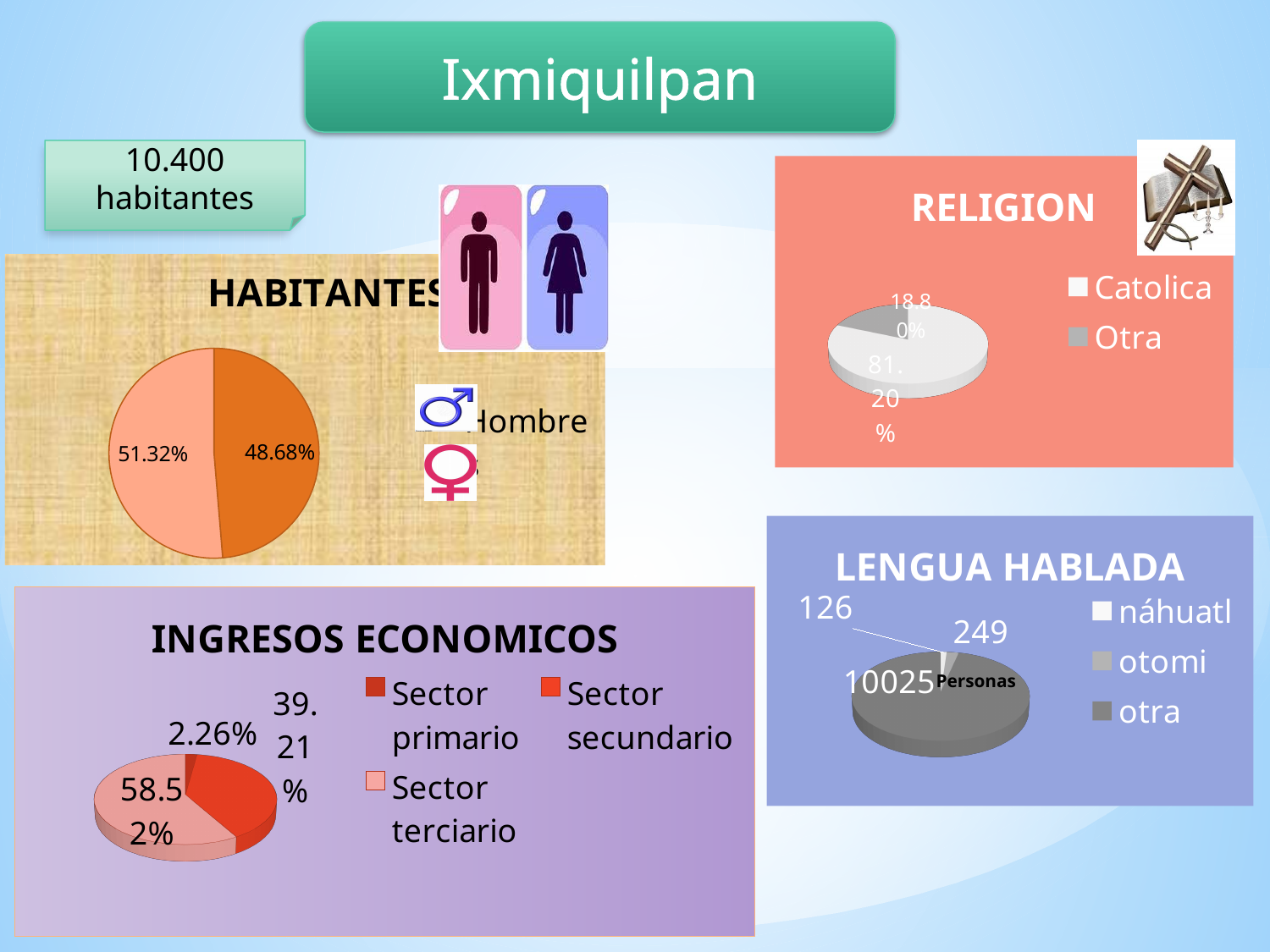
In the LENGUA HABLADA chart, what is the difference between the values for otomi and náhuatl? 123 In the LENGUA HABLADA chart, how many people are shown for náhuatl? 126 In the RELIGION chart, what percentage is shown for Catolica? 81.20% In the RELIGION chart, which category has the larger share, Catolica or Otra? Catolica In the INGRESOS ECONOMICOS chart, what percentage is shown for Sector primario? 2.26% How many entries does the legend of the INGRESOS ECONOMICOS chart list? 3 In the RELIGION chart, what percentage is shown for Otra? 18.80% In the LENGUA HABLADA chart, how many people are shown for otra? 10025 In the LENGUA HABLADA chart, which language category has the smallest value? náhuatl In the INGRESOS ECONOMICOS chart, what percentage is shown for Sector terciario? 58.52% In the INGRESOS ECONOMICOS chart, which sector has the largest share? Sector terciario What kind of chart is the HABITANTES chart? Pie chart